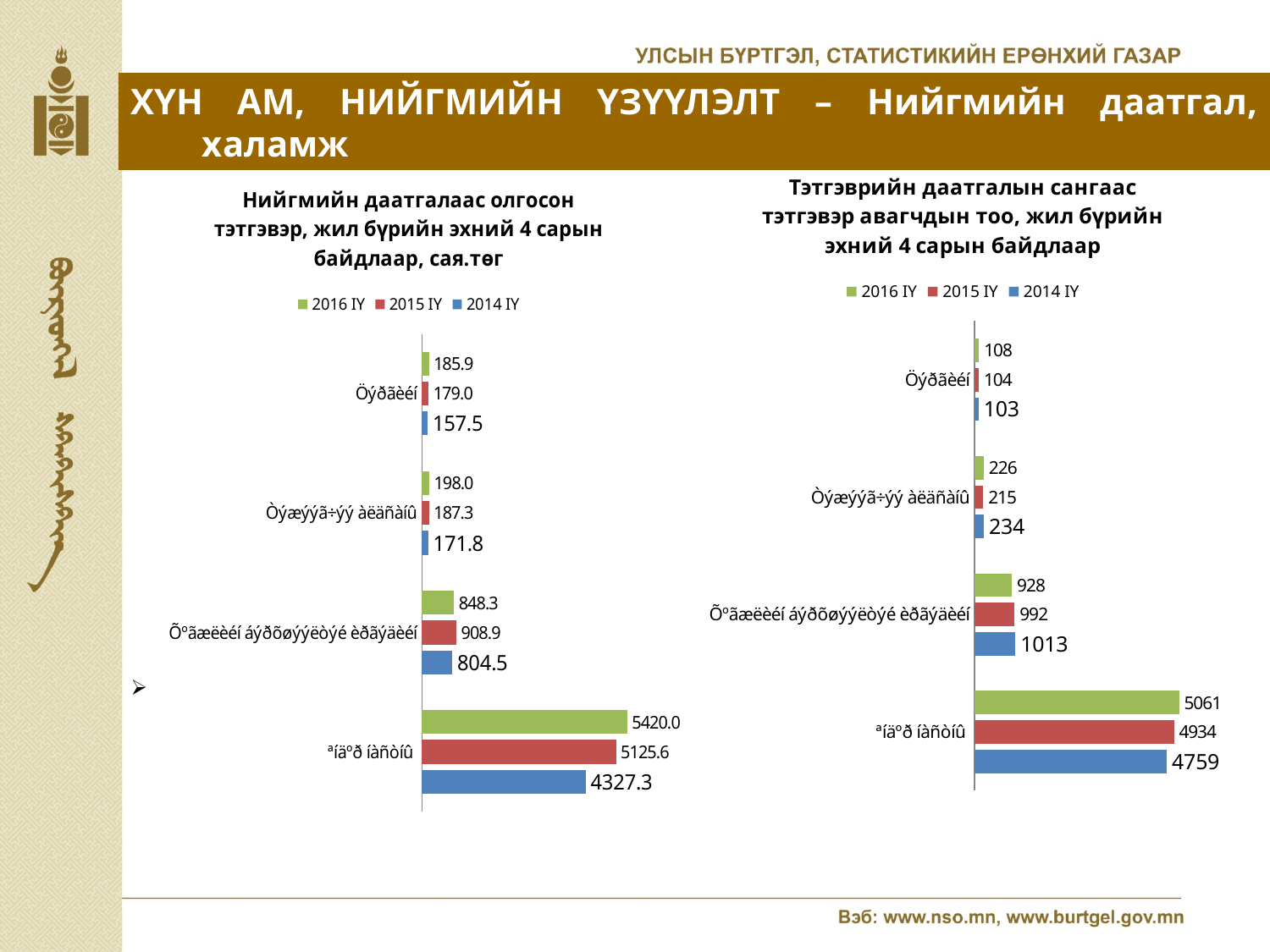
On the left chart (Нийгмийн даатгалаас олгосон тэтгэвэр), what is the 2015 IY value for the third category from the top? 908.9 On the right chart (Тэтгэврийн даатгалын сангаас тэтгэвэр авагчдын тоо), which is larger for the second category from the top: the 2016 IY value or the 2014 IY value? 2014 IY On the left chart (Нийгмийн даатгалаас олгосон тэтгэвэр), what is the 2014 IY value for the bottom category? 4327.3 On the left chart (Нийгмийн даатгалаас олгосон тэтгэвэр), what is the difference between the 2016 IY and 2015 IY values for the bottom category? 294.4 On the right chart (Тэтгэврийн даатгалын сангаас тэтгэвэр авагчдын тоо), how many categories are shown? 4 On the left chart (Нийгмийн даатгалаас олгосон тэтгэвэр), what kind of chart is shown? Bar chart On the left chart (Нийгмийн даатгалаас олгосон тэтгэвэр), what is the 2016 IY value for the bottom category? 5420.0 On the right chart (Тэтгэврийн даатгалын сангаас тэтгэвэр авагчдын тоо), what is the 2014 IY value for the third category from the top? 1013 On the left chart (Нийгмийн даатгалаас олгосон тэтгэвэр), how many series does the legend list? 3 On the right chart (Тэтгэврийн даатгалын сангаас тэтгэвэр авагчдын тоо), which series has the highest value for the bottom category? 2016 IY On the right chart (Тэтгэврийн даатгалын сангаас тэтгэвэр авагчдын тоо), what is the difference between the 2016 IY and 2014 IY values for the bottom category? 302 On the right chart (Тэтгэврийн даатгалын сангаас тэтгэвэр авагчдын тоо), what is the 2016 IY value for the bottom category? 5061